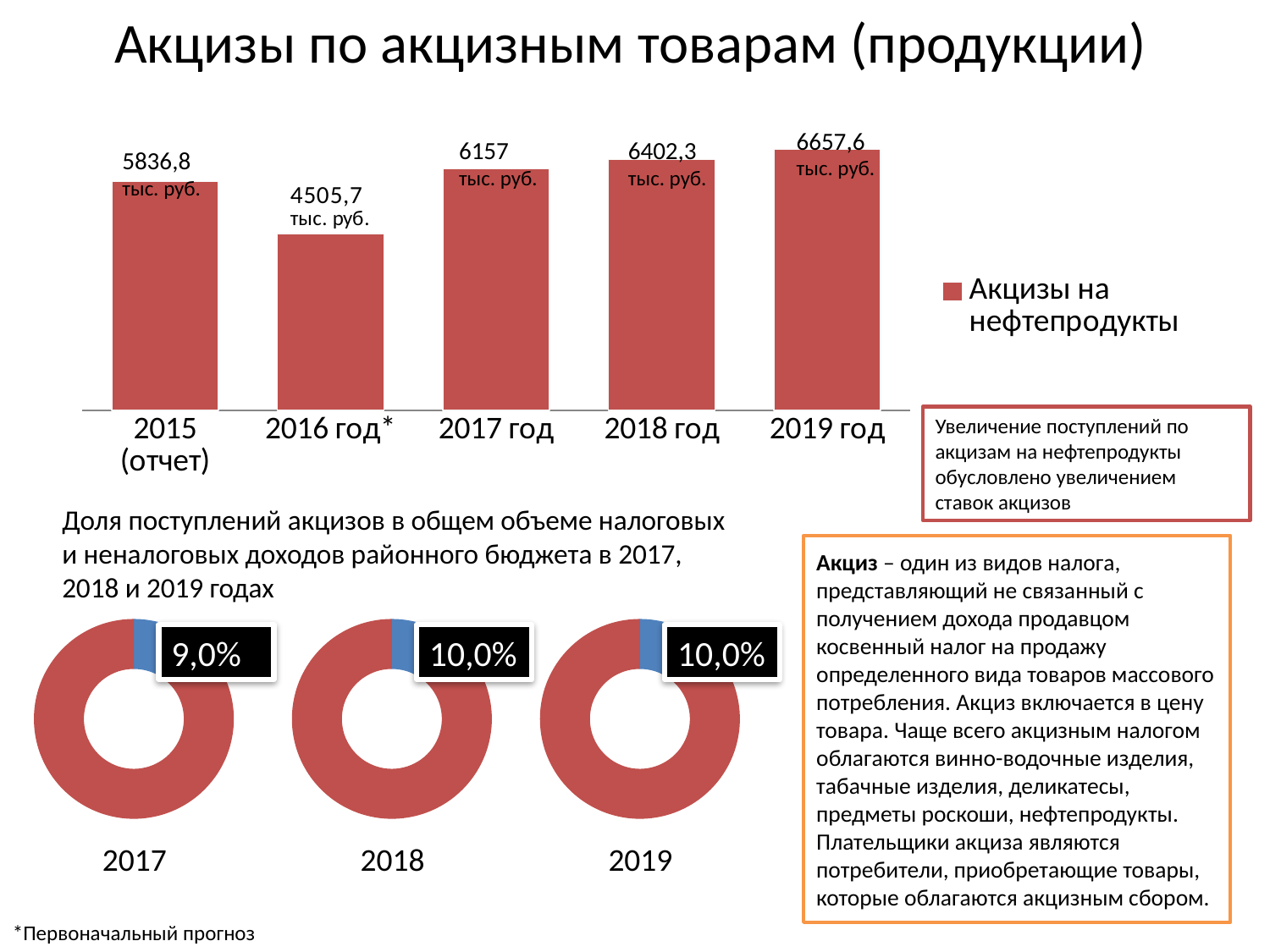
In the bar chart, what is the value for 2017 год? 6157 тыс. руб. In the donut chart for 2017, what share is shown by the data label? 9,0% In the bar chart, what is the difference between the values for 2019 год and 2015 (отчет)? 820,8 тыс. руб. In the bar chart, what is the difference between the values for 2018 год and 2017 год? 245,3 тыс. руб. In the bar chart, what is the value for 2016 год*? 4505,7 тыс. руб. In the bar chart, which year has the lowest value? 2016 год* How many bars are in the bar chart? 5 In the bar chart, which is larger: the value for 2015 (отчет) or the value for 2016 год*? 2015 (отчет) What series does the legend of the bar chart list? Акцизы на нефтепродукты In the bar chart, which year has the highest value? 2019 год In the bar chart, what is the value for 2019 год? 6657,6 тыс. руб. In the donut chart for 2018, what share is shown by the data label? 10,0%